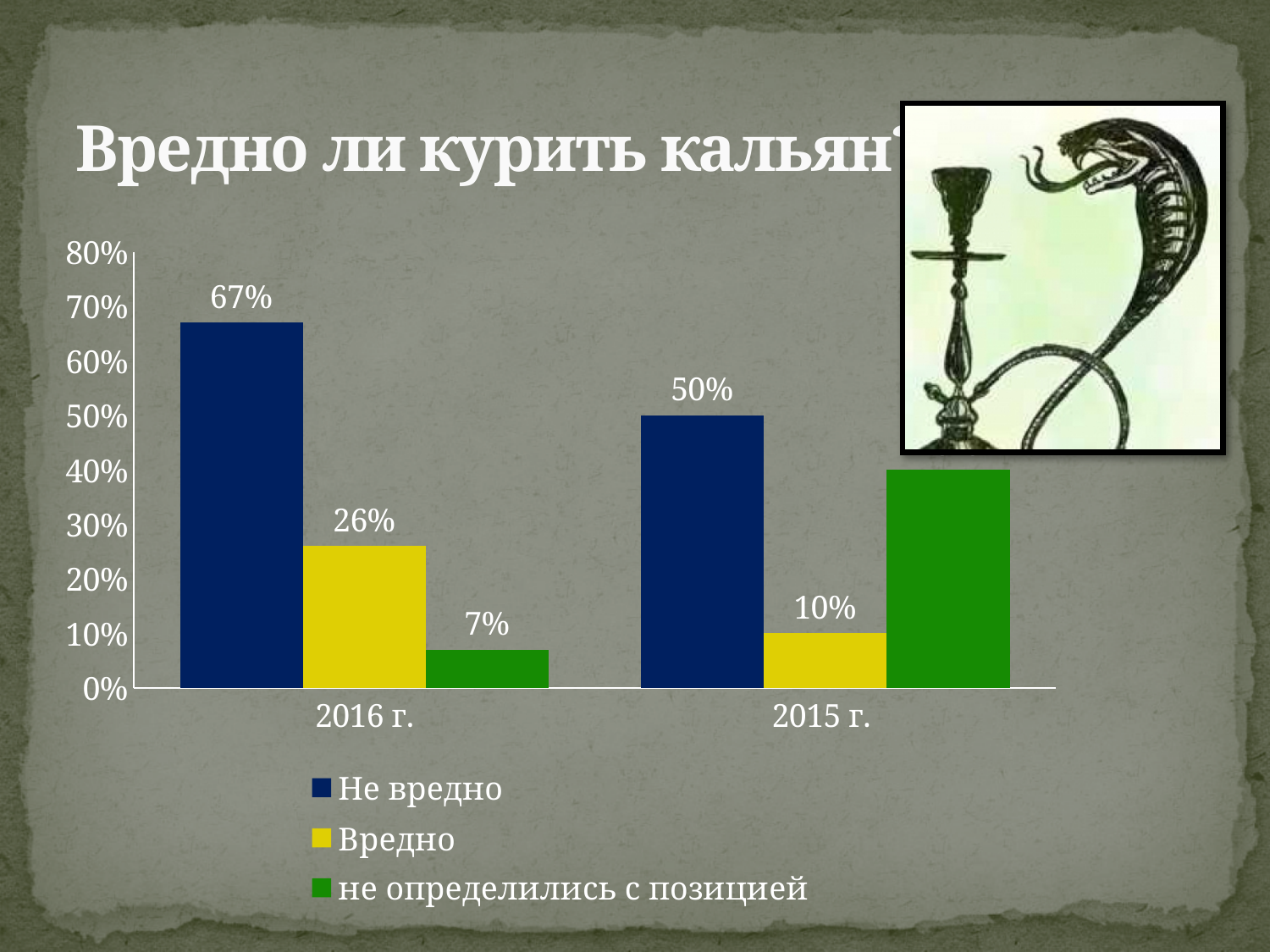
Which series has the lowest value in 2015 г.? Вредно Which is larger: "Вредно" in 2016 г. or "Вредно" in 2015 г.? 2016 г. What is the value for "Вредно" in 2015 г.? 10% Is the value for "не определились с позицией" in 2015 г. greater or less than 30%? greater Which series has the highest value in 2016 г.? Не вредно How many series does the legend list? 3 How many year categories are shown on the x axis? 2 What type of chart is shown on the slide? bar chart What is the difference between the "Не вредно" values for 2016 г. and 2015 г.? 17% What percentage of respondents in 2016 г. answered "Не вредно"? 67% What is the value for "Не вредно" in 2015 г.? 50% What is the value for "не определились с позицией" in 2016 г.? 7%